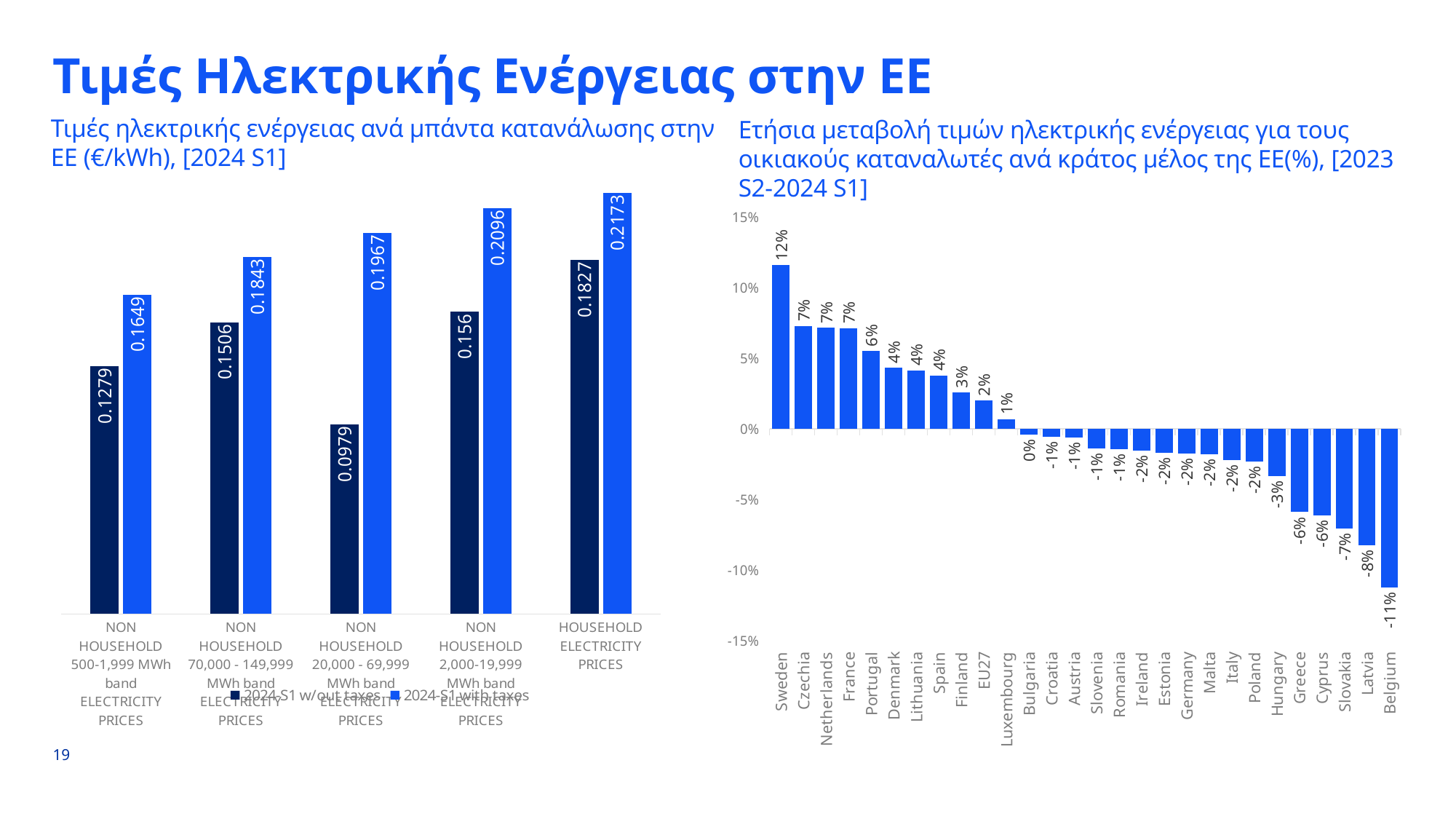
In the left chart (electricity prices per consumption band), what is the difference between the with-taxes and w/out-taxes values for the NON HOUSEHOLD 500-1,999 MWh band? 0.037 In the right chart (annual change in household electricity prices), which country has the lowest value? Belgium In the right chart (annual change in household electricity prices), what is the difference between the values for Sweden and Portugal? 6% In the right chart (annual change in household electricity prices), how many bars are plotted? 28 In the left chart (electricity prices per consumption band), which is larger: the 2024 S1 w/out taxes value for the NON HOUSEHOLD 2,000-19,999 MWh band or for the NON HOUSEHOLD 70,000 - 149,999 MWh band? NON HOUSEHOLD 2,000-19,999 MWh band In the left chart (electricity prices per consumption band), which category has the lowest 2024 S1 w/out taxes value? NON HOUSEHOLD 20,000 - 69,999 MWh band In the right chart (annual change in household electricity prices), what is the value for EU27? 2% What kind of chart is the right chart (annual change in household electricity prices)? Bar chart In the left chart (electricity prices per consumption band), what is the 2024 S1 w/out taxes value for the NON HOUSEHOLD 20,000 - 69,999 MWh band? 0.0979 In the left chart (electricity prices per consumption band), what is the 2024 S1 with taxes value for HOUSEHOLD ELECTRICITY PRICES? 0.2173 In the left chart (electricity prices per consumption band), how many series does the legend list? 2 In the right chart (annual change in household electricity prices), what is the value for Sweden? 12%